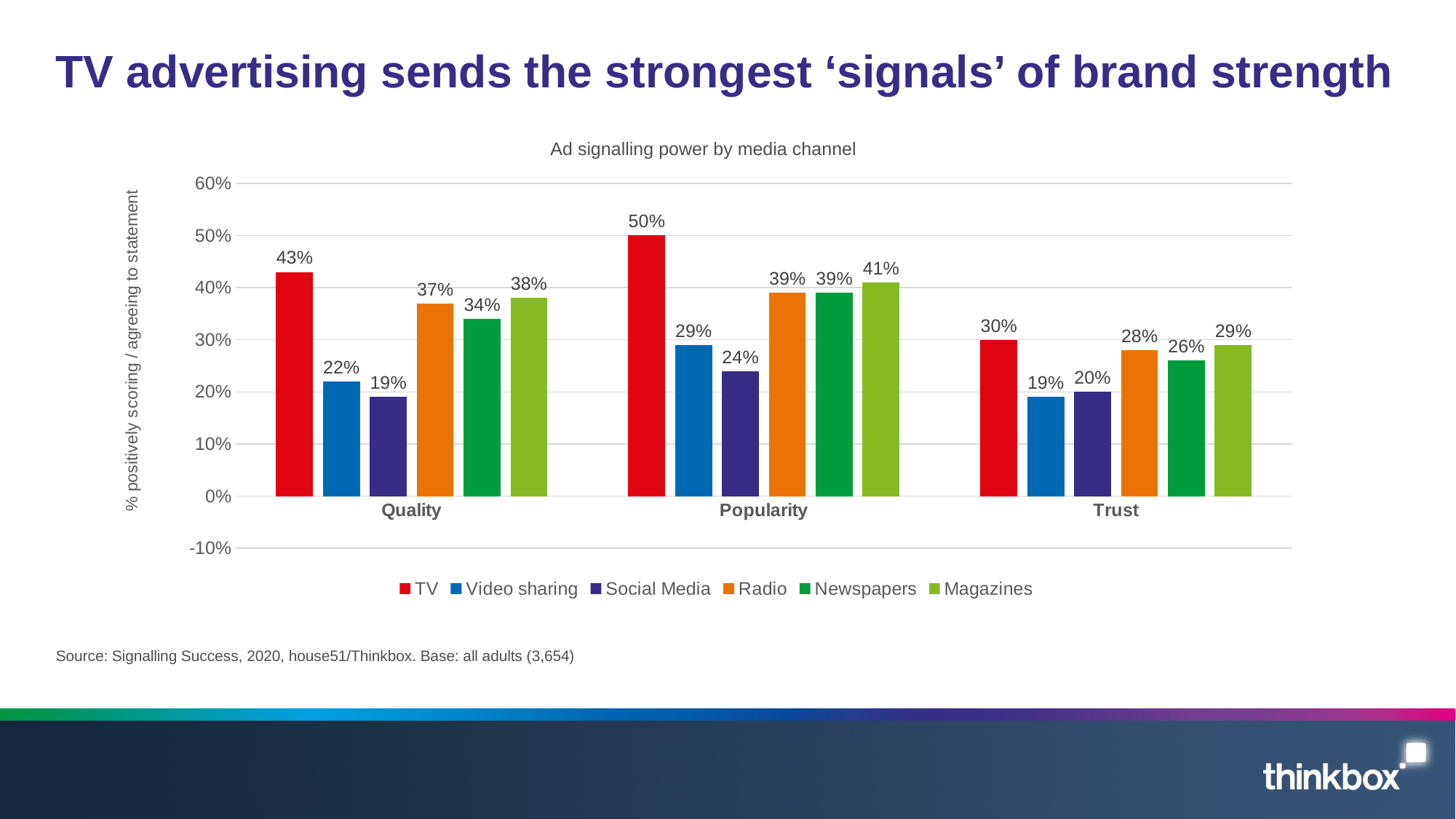
Which is larger in the Popularity category, Radio or Magazines? Magazines What is the value for Magazines in the Trust category? 29% Is the value for TV in the Quality category greater or less than 40%? greater How many series does the legend list? 6 What is the value for Social Media in the Quality category? 19% Which media channel has the highest value in the Trust category? TV What is the value for TV in the Popularity category? 50% Which media channel has the lowest value in the Popularity category? Social Media What is the title of the chart? Ad signalling power by media channel How many categories are shown on the x axis? 3 What is the difference between TV and Video sharing in the Quality category? 21 percentage points What kind of chart is shown on the slide? Bar chart